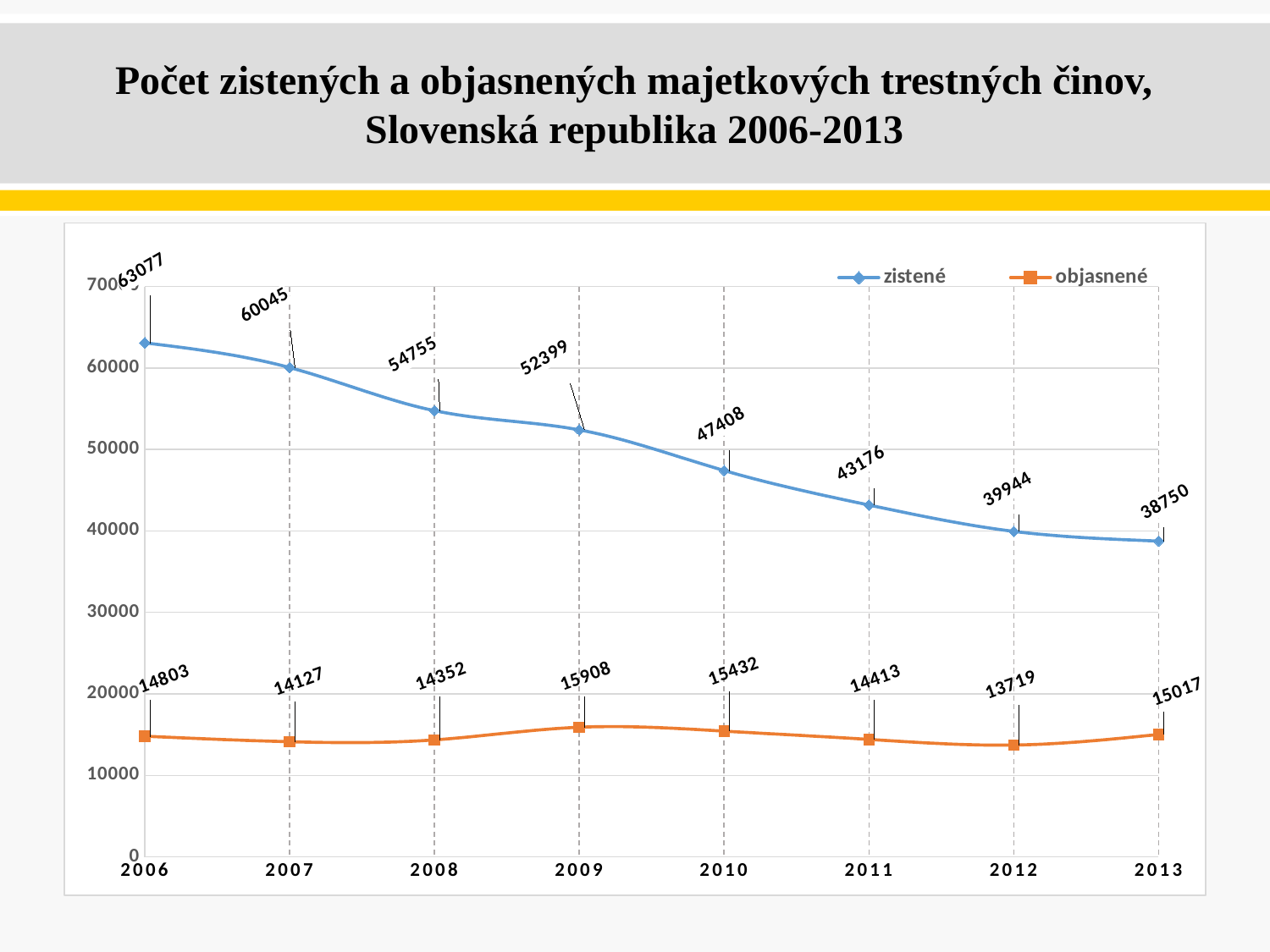
Is the value of zistené in 2010 greater or less than 50000? less What is the difference between zistené in 2006 and zistené in 2013? 24327 What kind of chart is shown on the slide? line chart In which year was zistené highest? 2006 What was the value of objasnené in 2009? 15908 What was the value of zistené in 2006? 63077 Does the zistené series rise or fall from 2006 to 2013? fall In which year was objasnené lowest? 2012 What was the value of zistené in 2013? 38750 How many years are shown on the x axis? 8 How many series does the legend list? 2 Which is larger: objasnené in 2009 or objasnené in 2012? objasnené in 2009